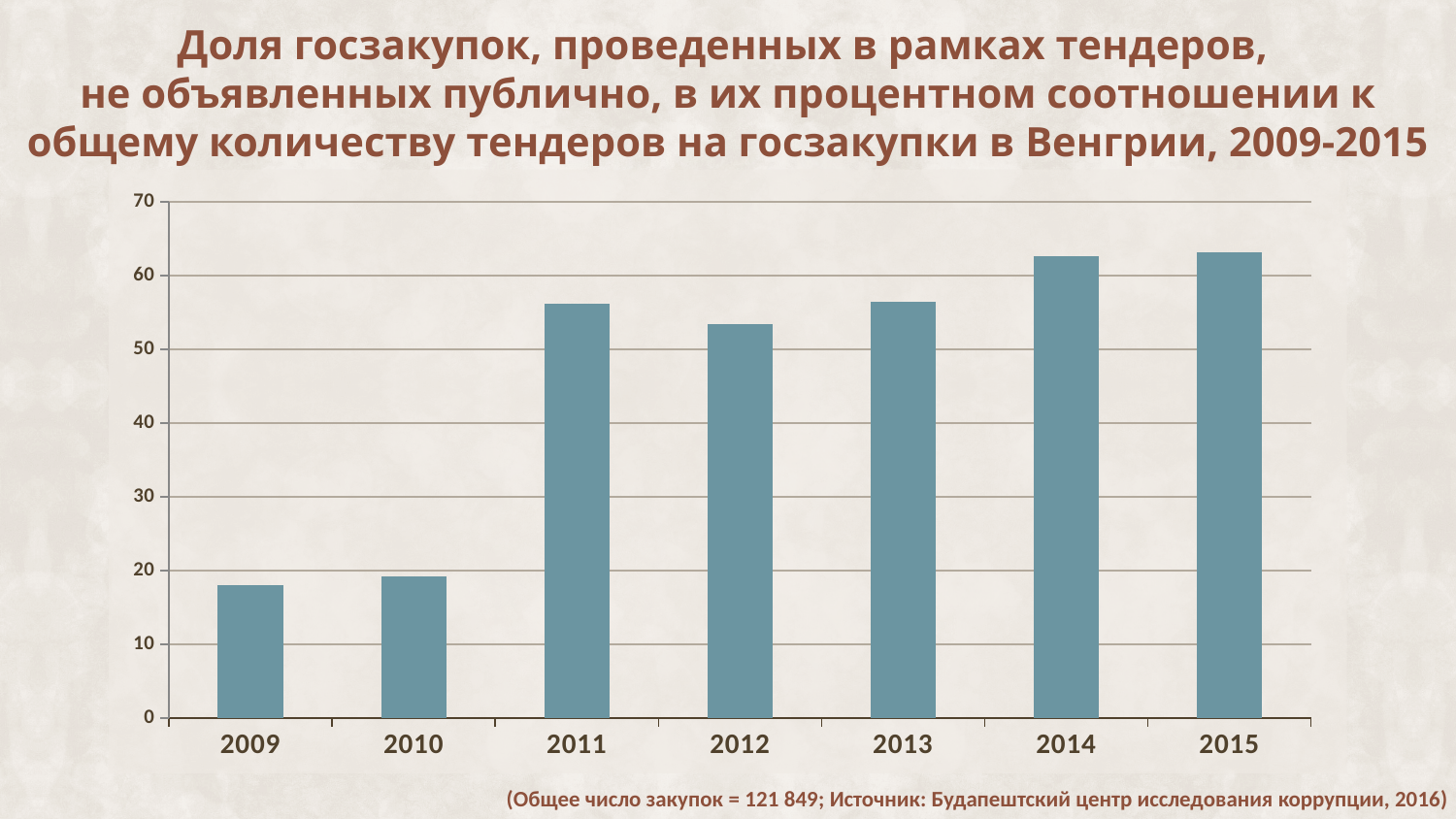
Which year has the larger value, 2012 or 2014? 2014 Is the value for 2010 greater or less than 30? less Is the value for 2012 greater or less than 60? less Is the value for 2014 greater or less than 60? greater Which year has the larger value, 2010 or 2011? 2011 How many years (categories) are plotted on the chart? 7 According to the note below the chart, what is the total number of procurements (Общее число закупок)? 121 849 What is the first year shown on the x axis? 2009 What kind of chart is shown on the slide? Bar chart Do the values generally rise or fall from 2009 to 2015? rise